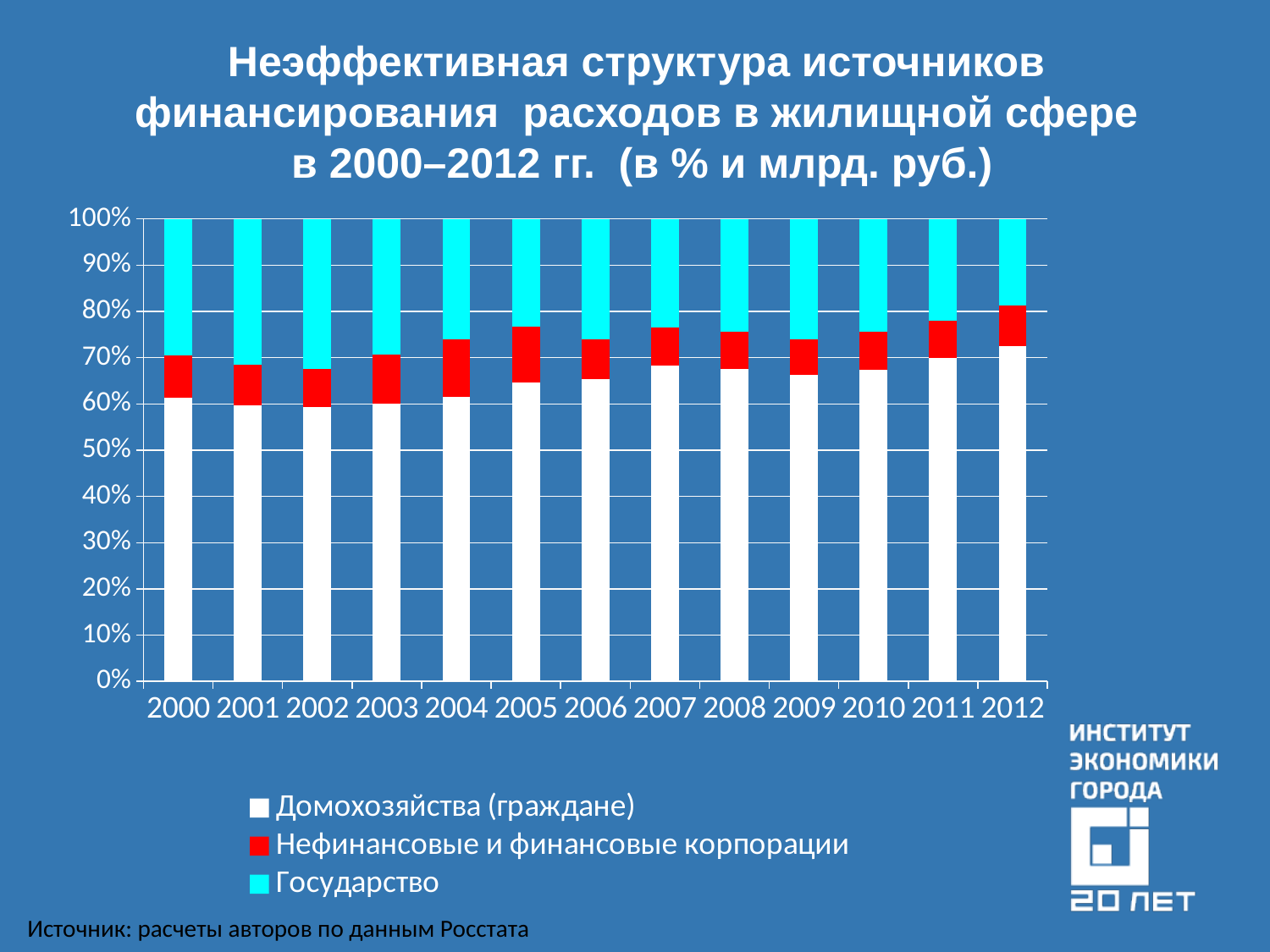
Which year has the largest share for Домохозяйства (граждане)? 2012 How many years are shown on the x axis of the chart? 13 What kind of chart is shown on the slide? Stacked bar chart Is the share of Домохозяйства (граждане) in 2012 greater or less than 70%? greater Which series is shown in white in the chart? Домохозяйства (граждане) Is the share of Домохозяйства (граждане) larger in 2000 or in 2012? 2012 Is the share of Домохозяйства (граждане) in 2007 greater or less than 60%? greater Is the share of Домохозяйства (граждане) in 2002 greater or less than 70%? less Which series is shown in red in the chart? Нефинансовые и финансовые корпорации Does the share of Домохозяйства (граждане) generally rise or fall from 2000 to 2012? rise How many series does the chart legend list? 3